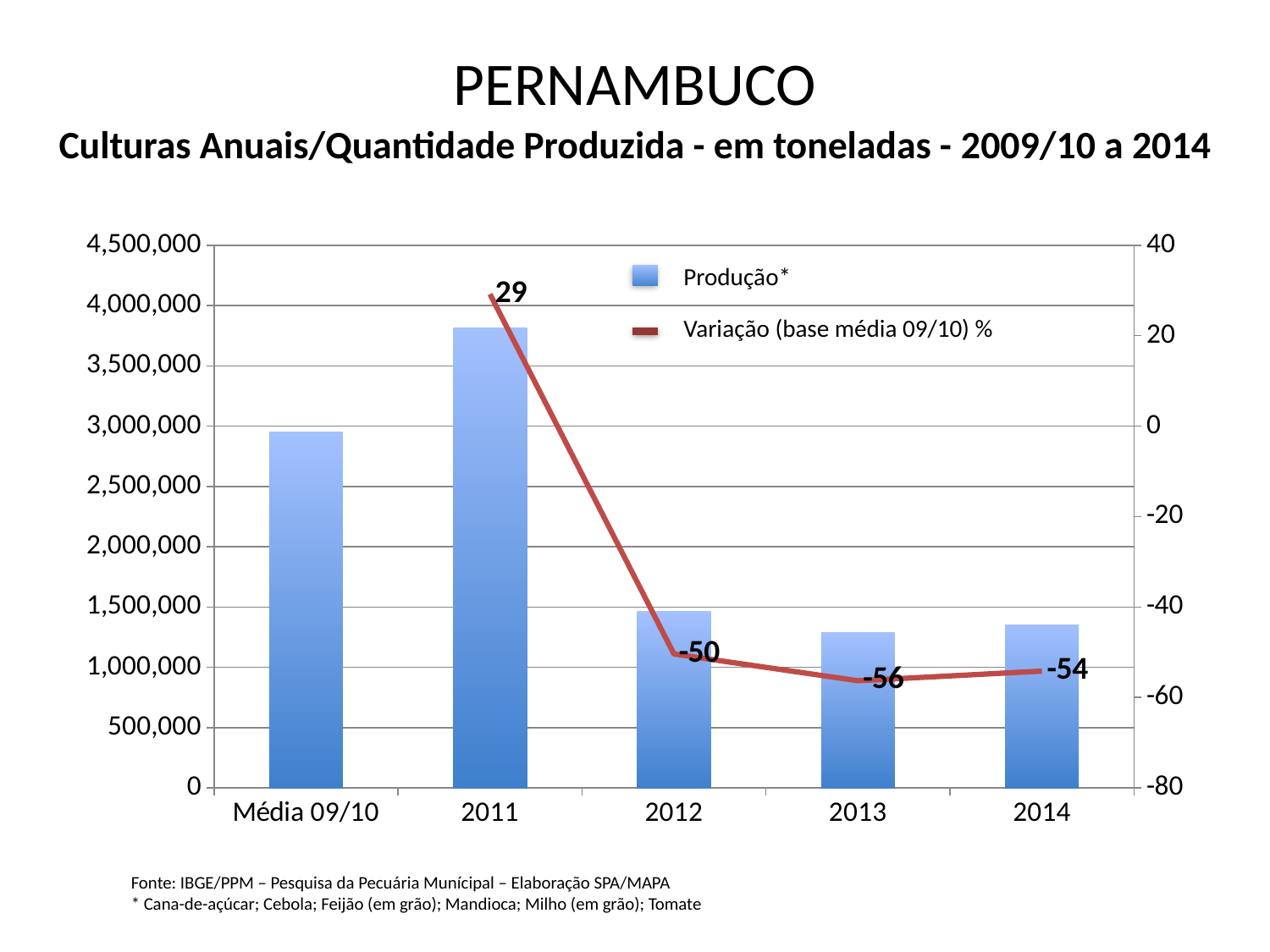
Which has a larger Produção* bar, Média 09/10 or 2012? Média 09/10 How many series does the legend list? 2 What is the value of the Variação (base média 09/10) % line for 2012? -50 Which year has the lowest value on the Variação (base média 09/10) % line? 2013 What is the difference between the Variação values for 2012 and 2013? 6 What is the value of the Variação (base média 09/10) % line for 2011? 29 What is the value of the Variação (base média 09/10) % line for 2013? -56 Which category has the highest Produção* bar? 2011 What is the value of the Variação (base média 09/10) % line for 2014? -54 How many categories are shown on the x axis? 5 Is the Produção* bar for 2013 greater or less than 1,500,000? less Is the Produção* bar for 2011 greater or less than 3,500,000? greater